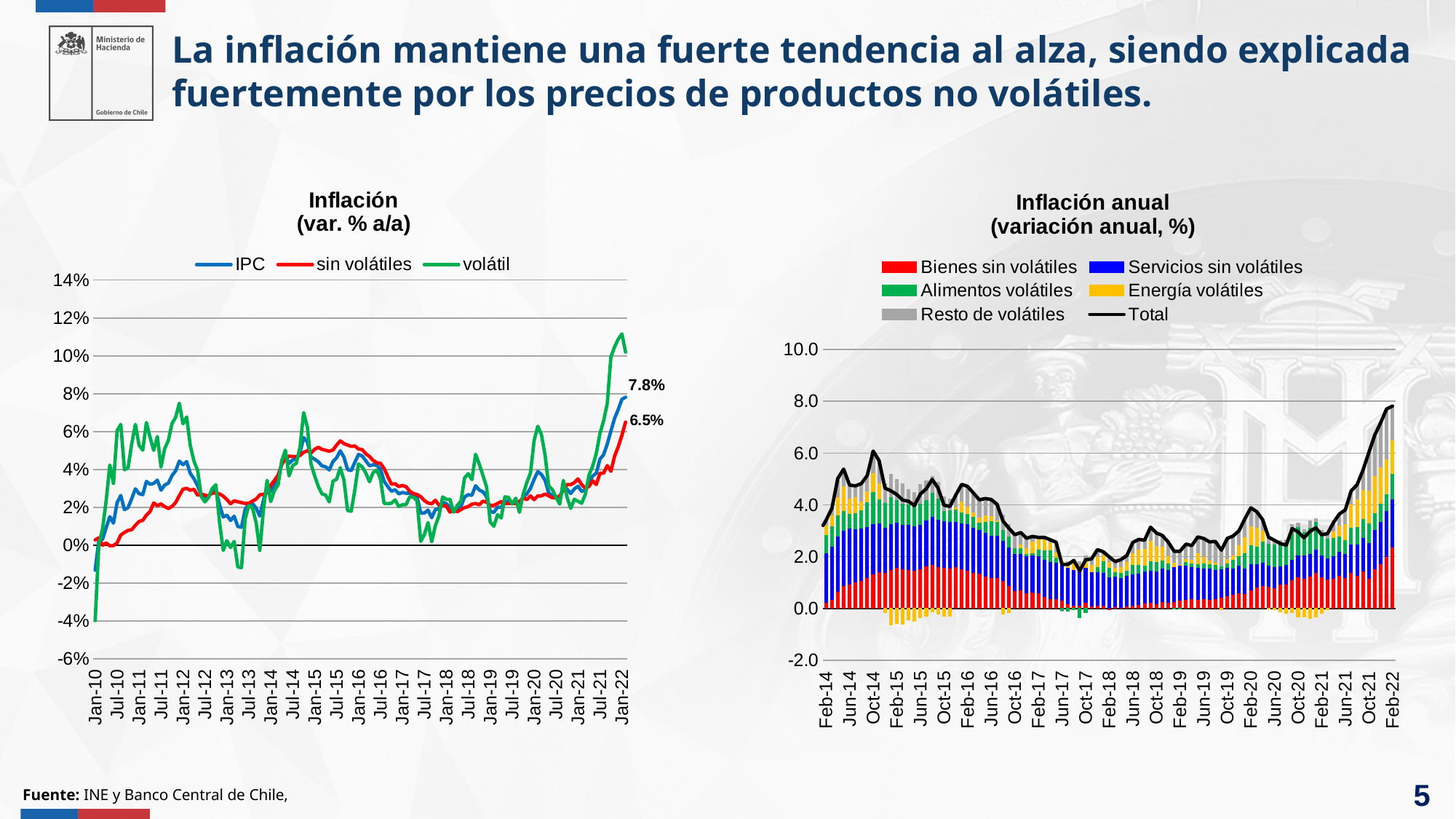
In the left chart 'Inflación (var. % a/a)', which is larger at Jan-22: IPC or 'sin volátiles'? IPC In the left chart 'Inflación (var. % a/a)', does the IPC series rise or fall between Jan-21 and Jan-22? rise In the right chart 'Inflación anual (variación anual, %)', which series is drawn as a line rather than as stacked bars? Total How many series does the legend of the left chart 'Inflación (var. % a/a)' list? 3 How many series does the legend of the right chart 'Inflación anual (variación anual, %)' list? 6 In the right chart 'Inflación anual (variación anual, %)', is the Total value at Feb-22 greater or less than 6.0? greater In the left chart 'Inflación (var. % a/a)', what colour is the 'volátil' line? green In the left chart 'Inflación (var. % a/a)', is the value of the 'volátil' series at Jan-22 greater or less than 8%? greater What kind of chart is the left chart 'Inflación (var. % a/a)'? line chart